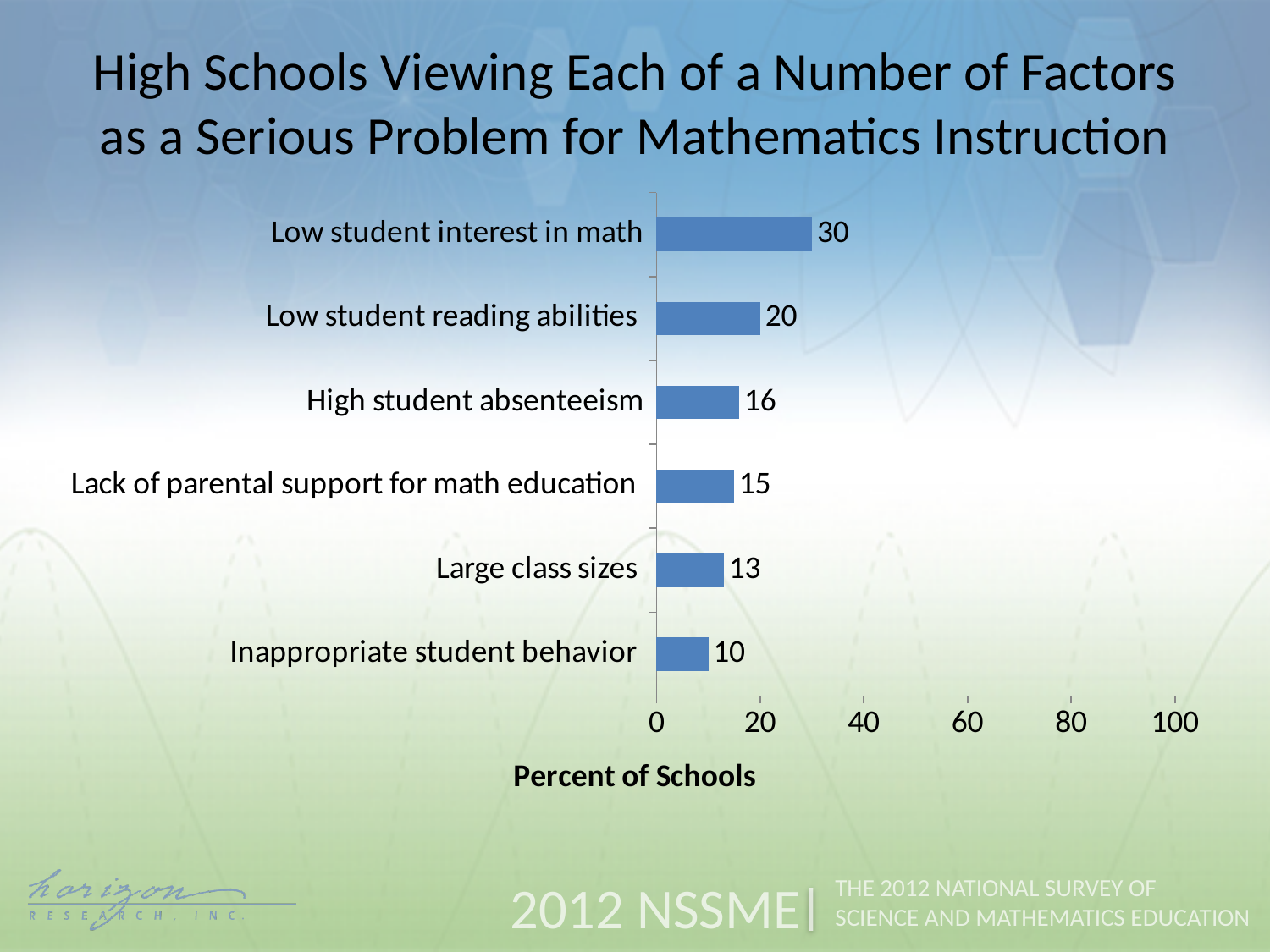
How many factors are shown in the chart? 6 What is the difference between the values for Low student interest in math and Low student reading abilities? 10 What percent of schools view low student interest in math as a serious problem? 30 What is the maximum value shown on the horizontal axis? 100 Is the value for Low student reading abilities greater or less than 40? less What is the label of the horizontal axis? Percent of Schools What is the value for Large class sizes? 13 Which factor has the lowest percent of schools? Inappropriate student behavior Which is larger, the value for High student absenteeism or the value for Large class sizes? High student absenteeism Which factor has the highest percent of schools? Low student interest in math What is the value for Lack of parental support for math education? 15 What kind of chart is shown on the slide? bar chart